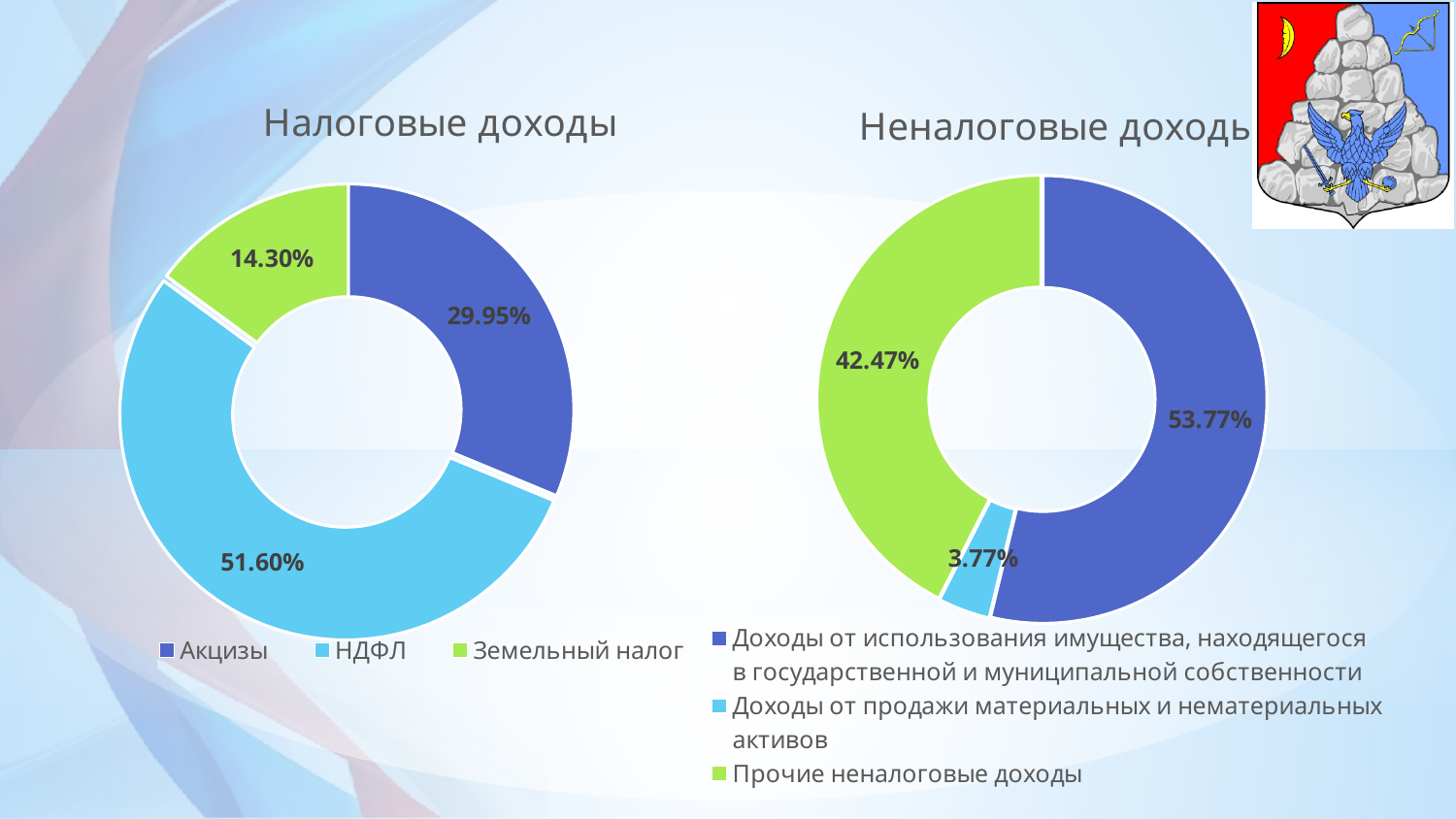
In the 'Налоговые доходы' chart, what is the value for НДФЛ? 51.60% In the 'Налоговые доходы' chart, what is the value for Акцизы? 29.95% What type of chart is used for 'Налоговые доходы'? Doughnut (pie) chart In the 'Налоговые доходы' chart, which category has the largest share? НДФЛ In the 'Налоговые доходы' chart, what is the difference between the НДФЛ and Акцизы values? 21.65% In the 'Налоговые доходы' chart, what is the value for Земельный налог? 14.30% In the 'Неналоговые доходы' chart, what is the value for Прочие неналоговые доходы? 42.47% In the 'Неналоговые доходы' chart, which category has the largest share? Доходы от использования имущества, находящегося в государственной и муниципальной собственности In the 'Неналоговые доходы' chart, which is larger: Прочие неналоговые доходы or Доходы от продажи материальных и нематериальных активов? Прочие неналоговые доходы In the 'Неналоговые доходы' chart, what is the value for Доходы от продажи материальных и нематериальных активов? 3.77% How many categories does the 'Неналоговые доходы' chart show? 3 In the 'Налоговые доходы' chart, which category has the smallest share? Земельный налог